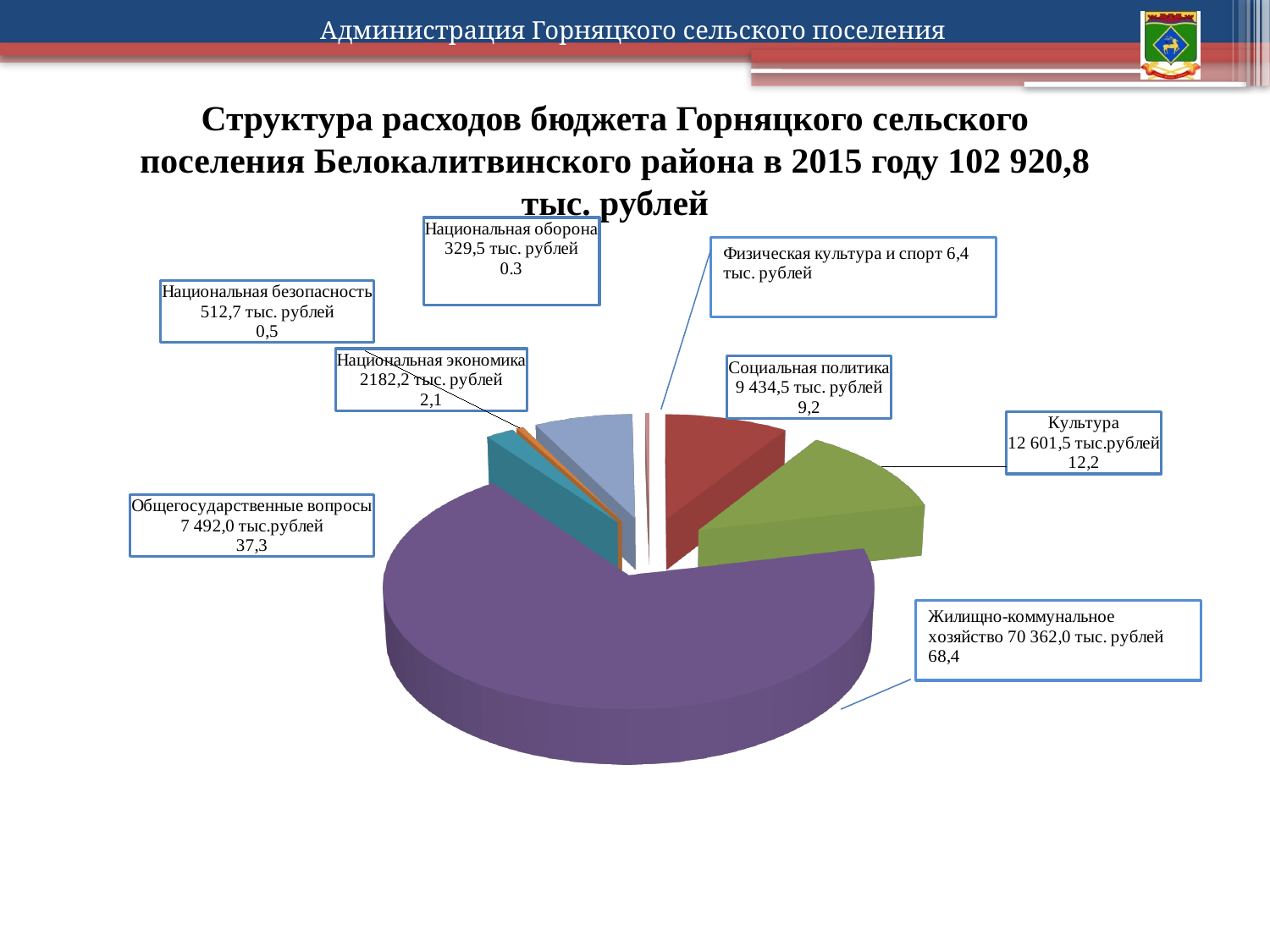
How many expenditure categories are labelled on the pie chart? 8 Which category has the largest expenditure on the pie chart? Жилищно-коммунальное хозяйство Which category has the smallest expenditure on the pie chart? Физическая культура и спорт What is the amount shown for Жилищно-коммунальное хозяйство? 70 362,0 тыс. рублей Which is larger, the expenditure for Культура or for Социальная политика? Культура What is the amount shown for Социальная политика? 9 434,5 тыс. рублей What is the amount shown for Национальная оборона? 329,5 тыс. рублей What is the amount shown for Культура? 12 601,5 тыс.рублей What is the difference between the amounts for Культура and Социальная политика? 3 167,0 тыс. рублей What total budget expenditure is stated in the chart title? 102 920,8 тыс. рублей What kind of chart is shown on the slide? Pie chart What share of the pie is labelled for Жилищно-коммунальное хозяйство? 68,4